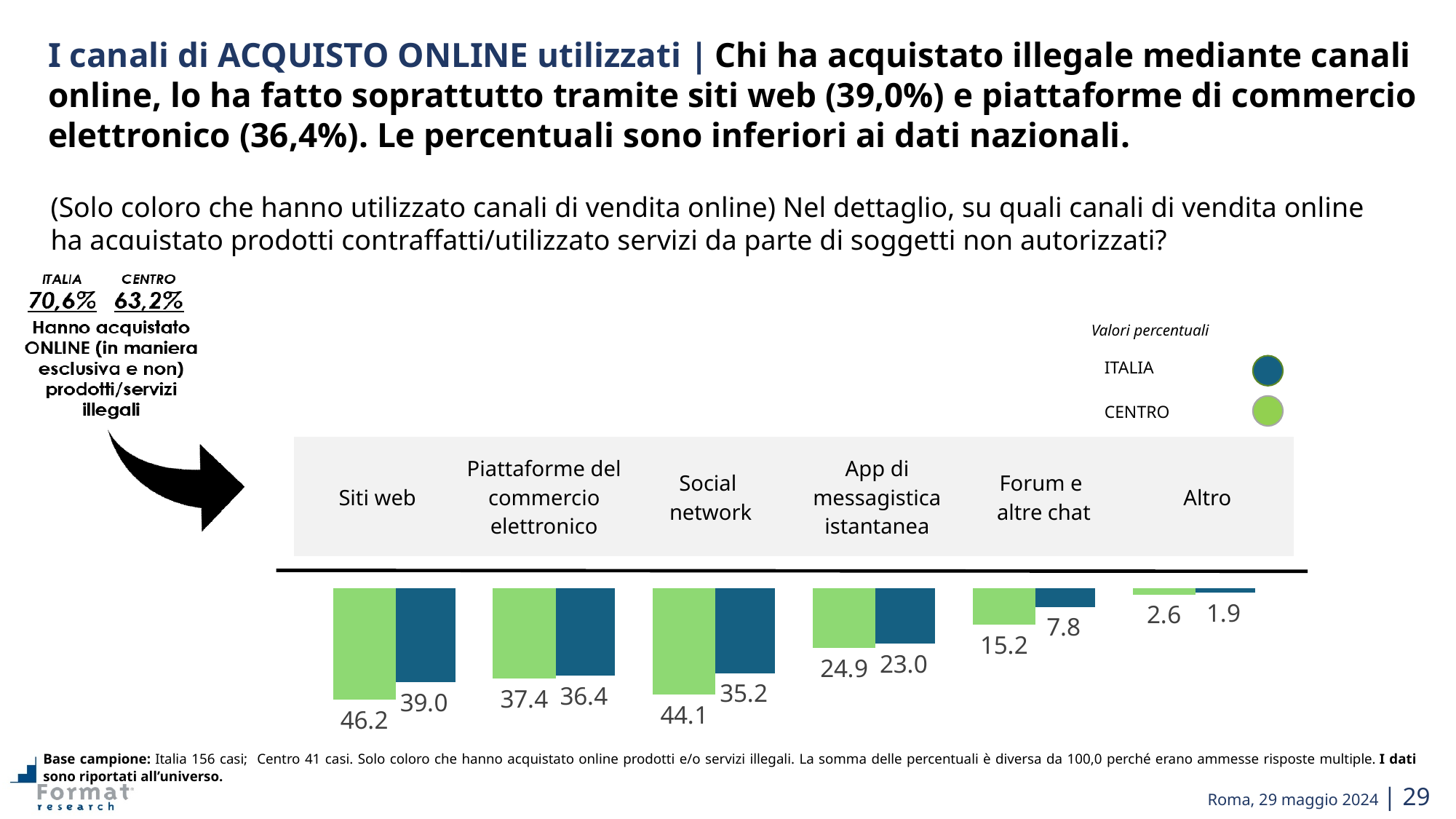
What is the difference between the green and blue bar values for Forum e altre chat? 7.4 How many categories (online channels) are shown in the chart? 6 Which category has the lowest blue bar value? Altro What is the value of the blue bar for Social network? 35.2 What kind of chart is shown on the slide? bar chart How many series does the chart legend list? 2 What is the value of the green bar for Siti web? 46.2 Which colour does the legend assign to the CENTRO series? green What is the value of the blue bar for Altro? 1.9 What is the value of the green bar for Forum e altre chat? 15.2 Which category has the highest green bar value? Siti web Which is larger for App di messaggistica istantanea: the green bar or the blue bar? the green bar (24.9)